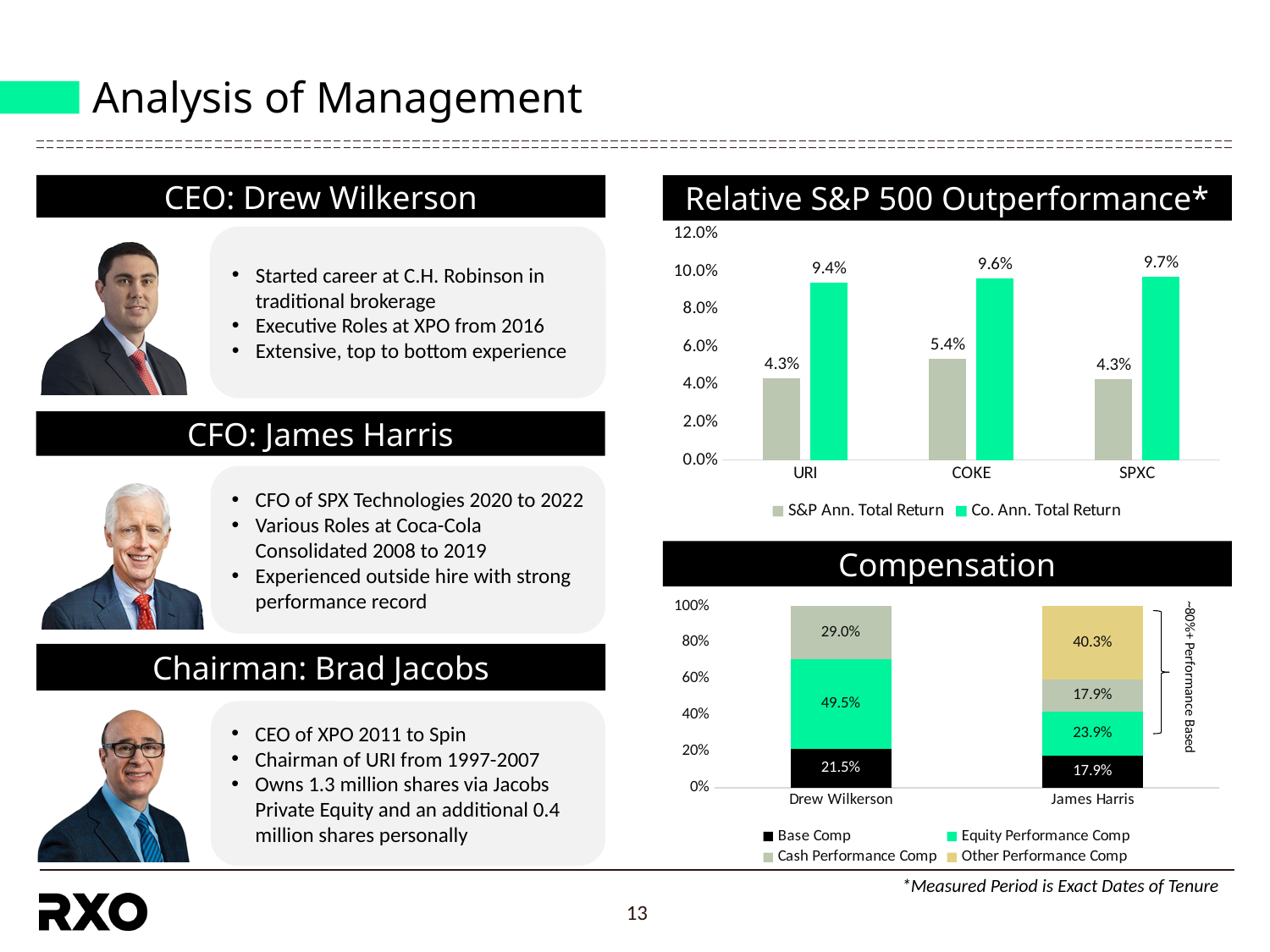
In the Relative S&P 500 Outperformance chart, how many companies are shown on the x axis? 3 In the Compensation chart, what is the Other Performance Comp share for James Harris? 40.3% In the Compensation chart, what is the Equity Performance Comp share for Drew Wilkerson? 49.5% In the Relative S&P 500 Outperformance chart, how many series does the legend list? 2 In the Relative S&P 500 Outperformance chart, which company has the highest Co. Ann. Total Return? SPXC In the Relative S&P 500 Outperformance chart, what is the S&P Ann. Total Return for URI? 4.3% In the Relative S&P 500 Outperformance chart, which company has the highest S&P Ann. Total Return? COKE What kind of chart is the Compensation chart? Stacked bar chart In the Compensation chart, how many series does the legend list? 4 In the Relative S&P 500 Outperformance chart, what is the difference between the Co. Ann. Total Return and the S&P Ann. Total Return for SPXC? 5.4% In the Relative S&P 500 Outperformance chart, what is the Co. Ann. Total Return for COKE? 9.6% In the Compensation chart, which person has the larger Base Comp share, Drew Wilkerson or James Harris? Drew Wilkerson